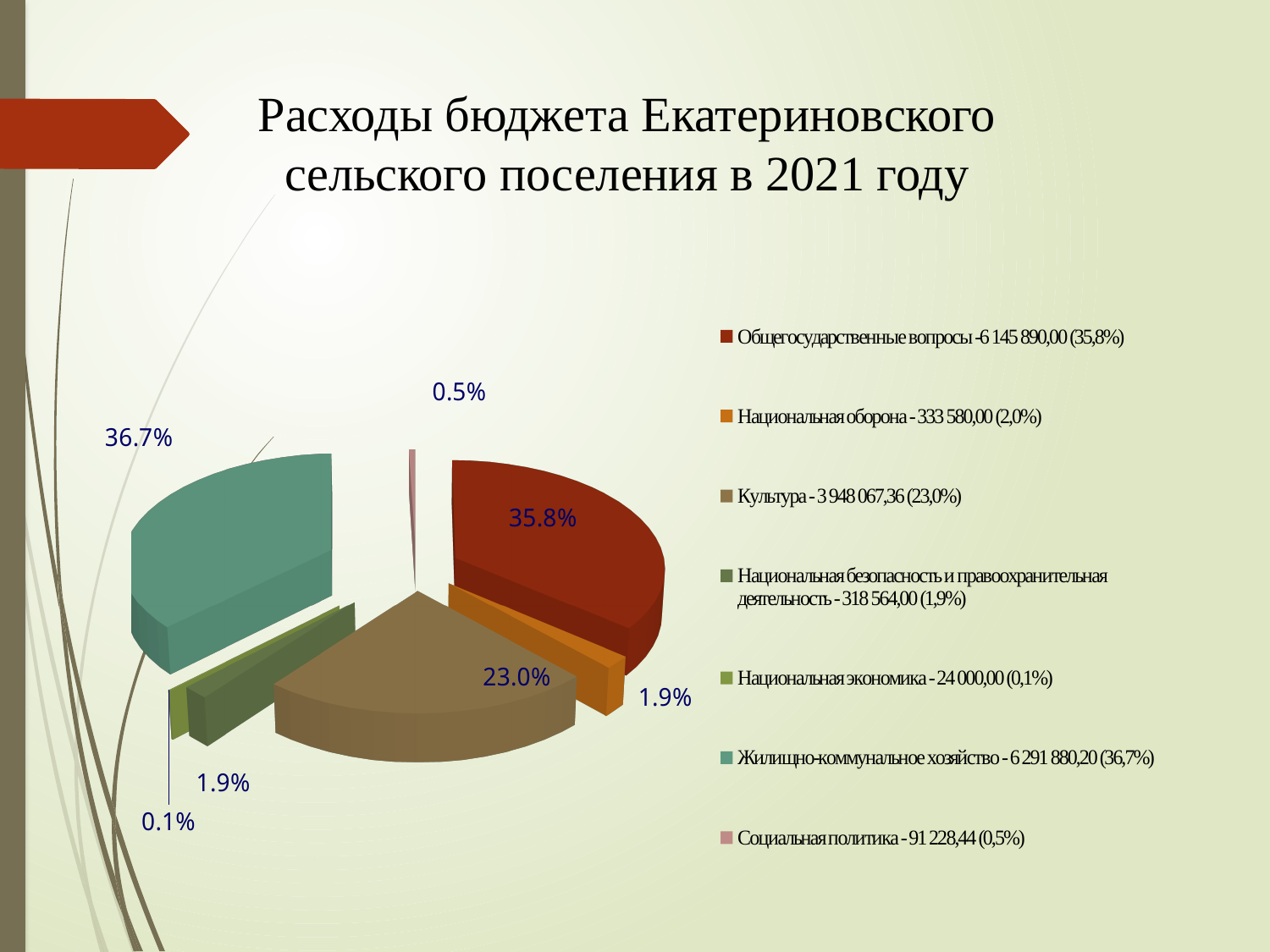
What share of the pie does Общегосударственные вопросы have? 35.8% How many slices does the pie chart have? 7 How many entries does the legend list? 7 Which category has the largest share of the pie? Жилищно-коммунальное хозяйство Which category has the smallest share of the pie? Национальная экономика What is the title of the slide? Расходы бюджета Екатериновского сельского поселения в 2021 году What kind of chart is shown on the slide? pie chart What share of the pie does Социальная политика have? 0.5% According to the legend, what amount is given for Культура? 3 948 067,36 Which is larger: the share for Общегосударственные вопросы or the share for Жилищно-коммунальное хозяйство? Жилищно-коммунальное хозяйство What is the difference in percentage points between the share for Общегосударственные вопросы (35.8%) and the share for Культура (23.0%)? 12.8 What share of the pie does Культура have? 23.0%